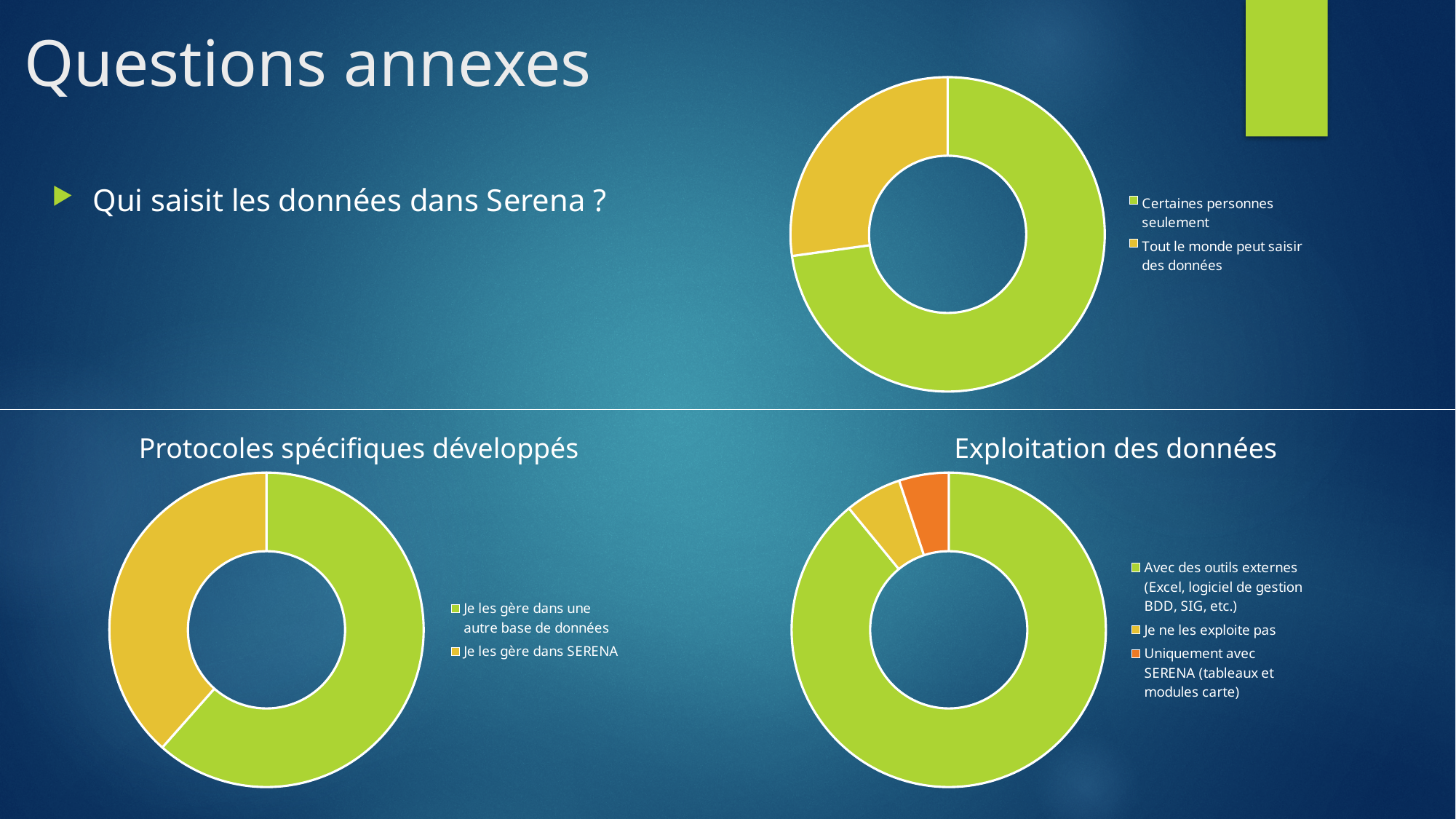
In the chart titled 'Protocoles spécifiques développés', is the share for 'Je les gère dans SERENA' larger or smaller than the share for 'Je les gère dans une autre base de données'? Smaller What kind of chart is the top-right chart on the slide? Doughnut (pie) chart What is the title of the bottom-right chart on the slide? Exploitation des données In the chart titled 'Exploitation des données', is the share for 'Je ne les exploite pas' larger or smaller than the share for 'Avec des outils externes (Excel, logiciel de gestion BDD, SIG, etc.)'? Smaller In the top-right chart, which category has the smallest share? Tout le monde peut saisir des données In the chart titled 'Exploitation des données', which category has the largest share? Avec des outils externes (Excel, logiciel de gestion BDD, SIG, etc.) In the top-right chart, which category has the largest share? Certaines personnes seulement In the chart titled 'Protocoles spécifiques développés', which category has the larger share? Je les gère dans une autre base de données How many slices does the chart titled 'Protocoles spécifiques développés' have? 2 In the chart titled 'Exploitation des données', what colour is the slice for 'Uniquement avec SERENA (tableaux et modules carte)'? Orange How many categories does the legend of the top-right chart list? 2 How many categories does the legend of the chart titled 'Exploitation des données' list? 3